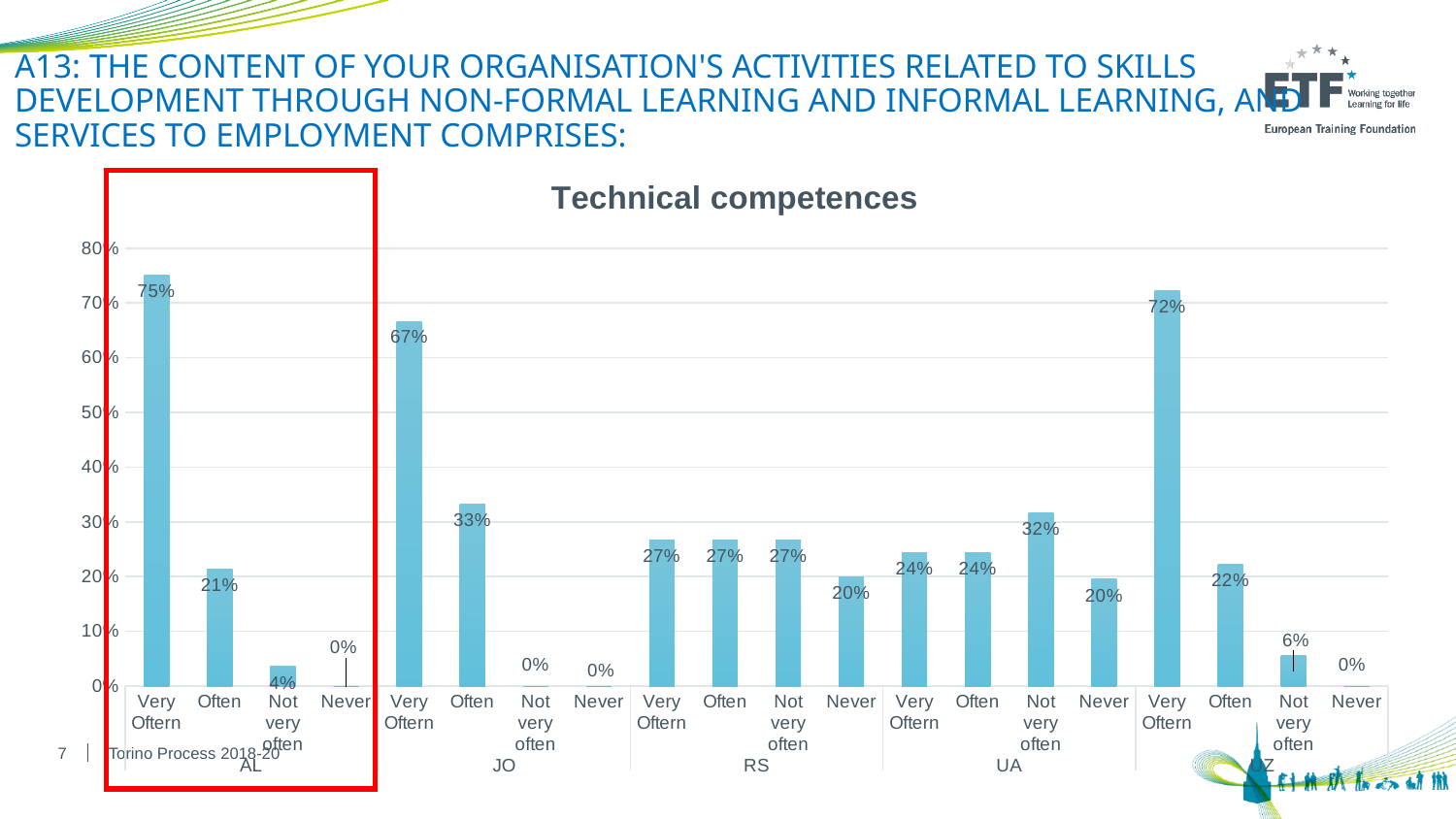
What is the title of the chart? Technical competences What is the value for "Never" in the RS group? 20% Which is larger: "Often" in JO or "Often" in UZ? Often in JO What is the value for "Very Oftern" in the AL group? 75% Is the value for "Very Oftern" in the JO group greater or less than 60%? greater How many country groups are shown on the x axis? 5 What is the difference between the "Very Oftern" values for AL and UZ? 3% What is the value for "Often" in the JO group? 33% Which country group has the highest "Very Oftern" value? AL What is the value for "Not very often" in the UA group? 32% What kind of chart is shown on the slide? Bar chart Within the UZ group, which category has the lowest value? Never